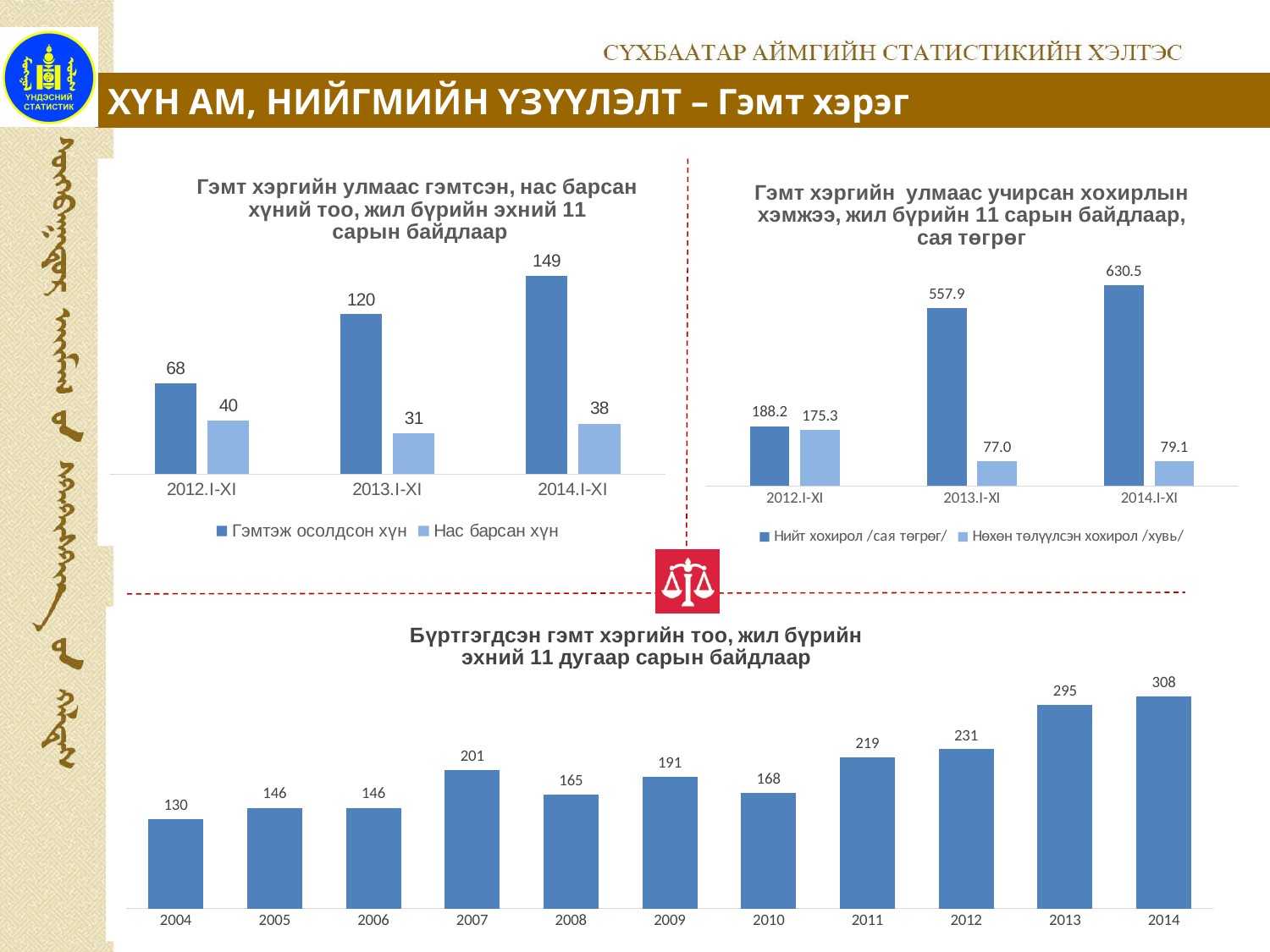
In the top-right chart 'Гэмт хэргийн улмаас учирсан хохирлын хэмжээ', what is the value of 'Нөхөн төлүүлсэн хохирол /хувь/' for 2013.I-XI? 77.0 In the top-left chart 'Гэмт хэргийн улмаас гэмтсэн, нас барсан хүний тоо', how many series does the legend list? 2 In the bottom chart 'Бүртгэгдсэн гэмт хэргийн тоо', what is the value for 2007? 201 In the top-left chart 'Гэмт хэргийн улмаас гэмтсэн, нас барсан хүний тоо', what is the value of 'Нас барсан хүн' for 2012.I-XI? 40 In the bottom chart 'Бүртгэгдсэн гэмт хэргийн тоо', how many years are shown on the x axis? 11 What kind of chart is the bottom chart 'Бүртгэгдсэн гэмт хэргийн тоо'? Bar chart In the bottom chart 'Бүртгэгдсэн гэмт хэргийн тоо', which year has the lowest value? 2004 In the top-right chart 'Гэмт хэргийн улмаас учирсан хохирлын хэмжээ', what is the value of 'Нийт хохирол /сая төгрөг/' for 2014.I-XI? 630.5 In the bottom chart 'Бүртгэгдсэн гэмт хэргийн тоо', which year has the highest value? 2014 In the top-left chart 'Гэмт хэргийн улмаас гэмтсэн, нас барсан хүний тоо', what is the value of 'Гэмтэж осолдсон хүн' for 2013.I-XI? 120 In the top-right chart 'Гэмт хэргийн улмаас учирсан хохирлын хэмжээ', which is larger for 2012.I-XI: 'Нийт хохирол /сая төгрөг/' or 'Нөхөн төлүүлсэн хохирол /хувь/'? Нийт хохирол /сая төгрөг/ In the bottom chart 'Бүртгэгдсэн гэмт хэргийн тоо', what is the difference between the values for 2014 and 2013? 13